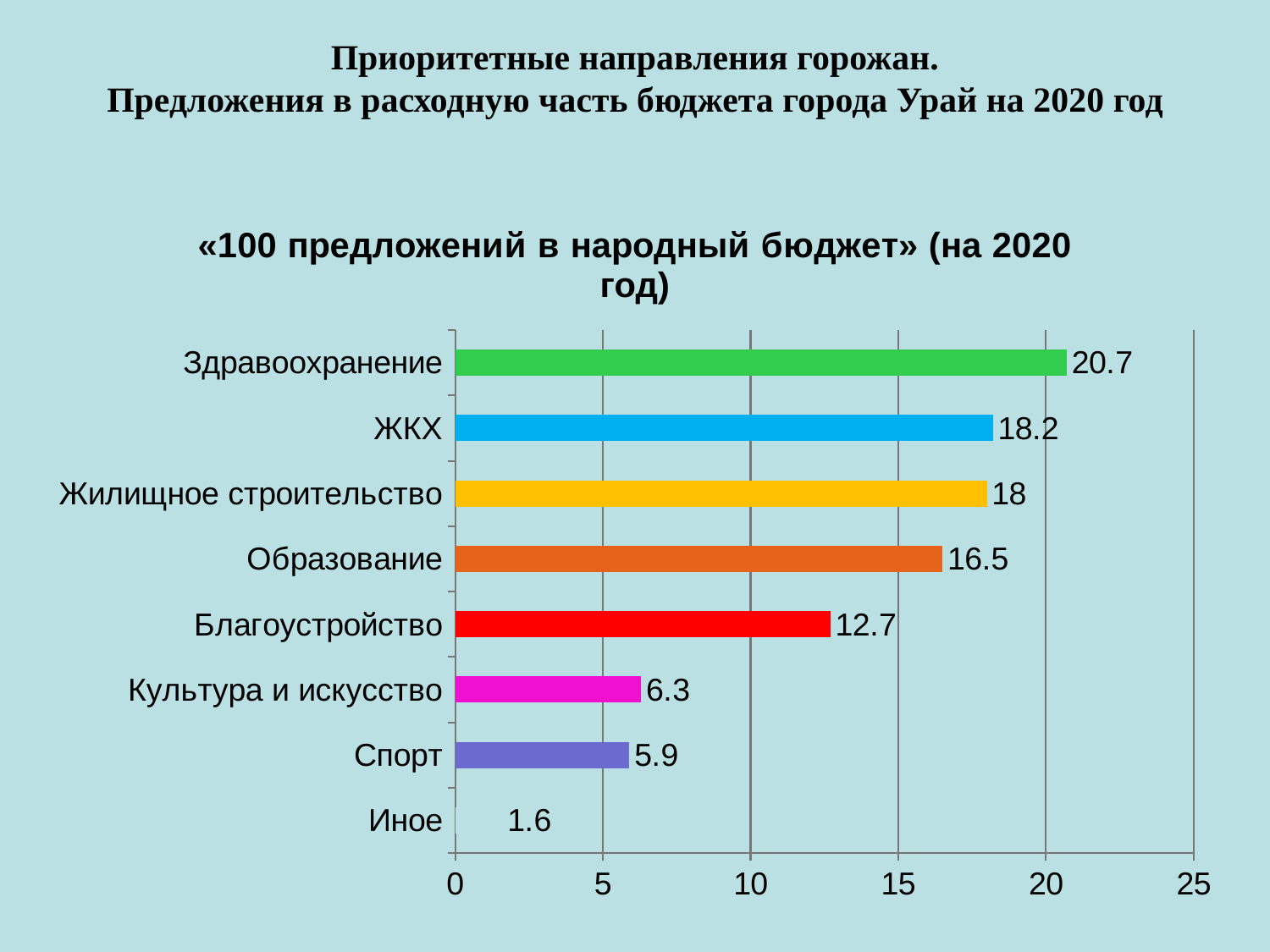
How many categories are shown in the chart? 8 What is the difference between the values for ЖКХ and Жилищное строительство? 0.2 Which is larger, the value for Благоустройство or the value for Культура и искусство? Благоустройство What is the title of the chart? «100 предложений в народный бюджет» (на 2020 год) Which category has the highest value? Здравоохранение What is the value for Образование? 16.5 What is the difference between the values for Здравоохранение and Спорт? 14.8 What is the value for Здравоохранение? 20.7 Is the value for Образование greater or less than 15? greater Which category has the lowest value? Иное What is the value for Иное? 1.6 What kind of chart is shown on the slide? bar chart